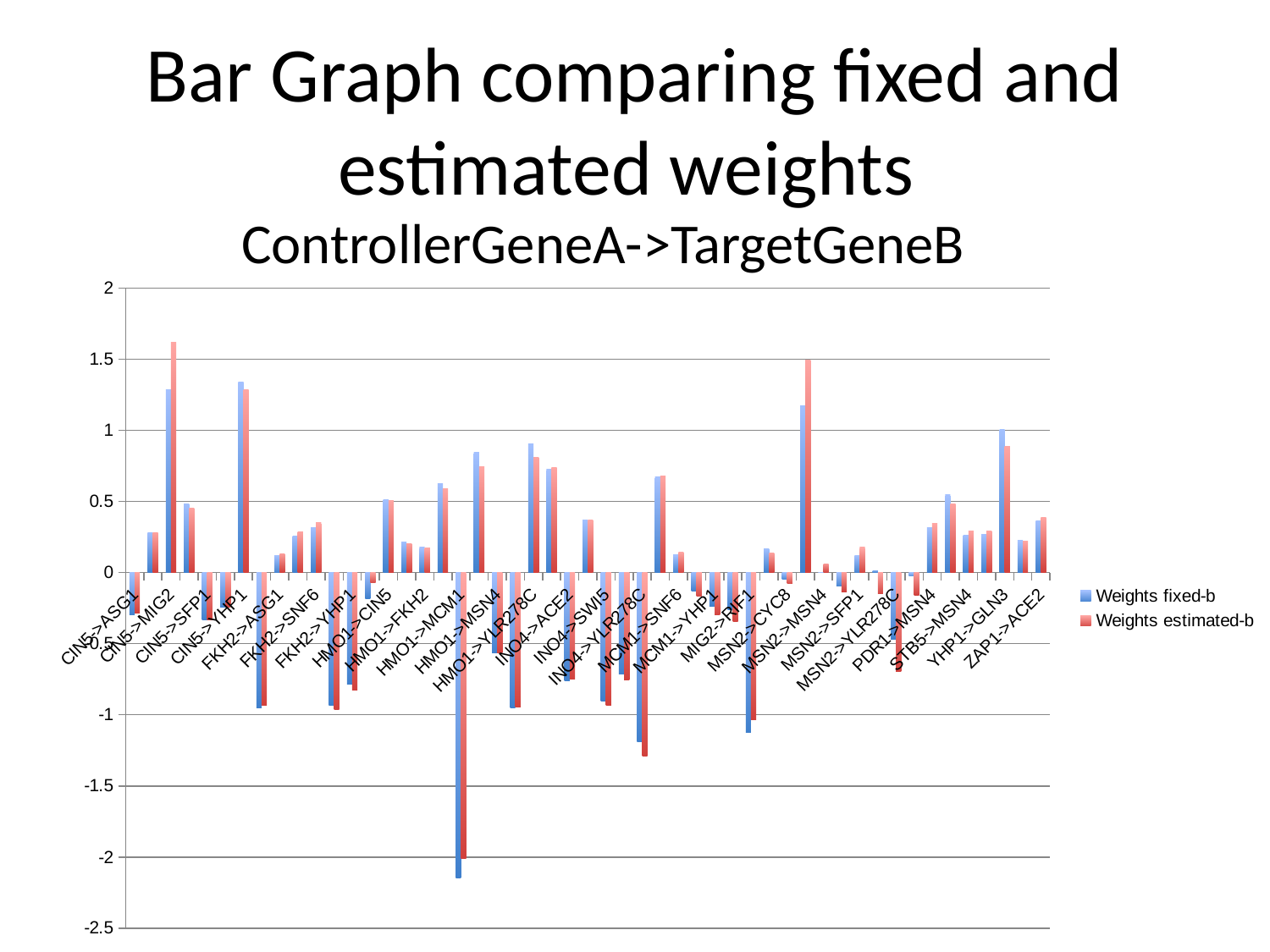
Is the highest value for Weights fixed-b greater or less than 1? greater Is the highest value for Weights estimated-b greater or less than 1? greater What kind of chart is shown on the slide? bar chart Does any bar in the chart reach a value of 2 or more? No What is the highest value marked on the vertical axis? 2 What is the lowest value marked on the vertical axis? -2.5 Which series is drawn in blue? Weights fixed-b What are the two series named in the legend? Weights fixed-b and Weights estimated-b How many series does the legend list? 2